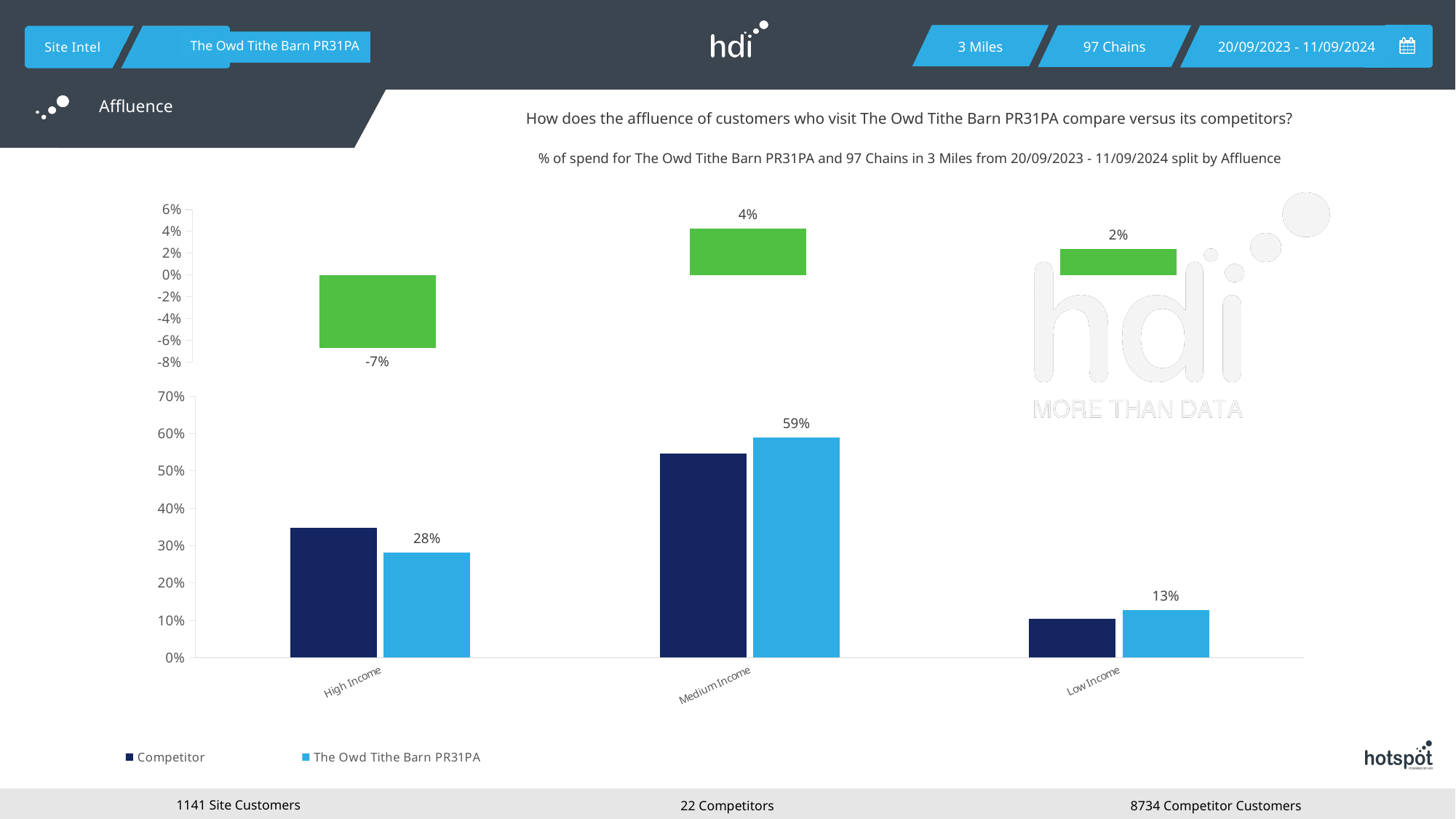
In the top chart, what is the value shown for the High Income category? -7% In the top chart, what is the value shown for the Medium Income category? 4% How many series does the legend of the bottom chart list? 2 In the bottom chart, which category has the highest value for The Owd Tithe Barn PR31PA? Medium Income In the top chart, which category has the lowest value? High Income In the bottom chart, is the Competitor value for Medium Income greater or less than 50%? greater In the bottom chart, what is the difference between The Owd Tithe Barn PR31PA values for Medium Income and High Income? 31% In the bottom chart, which is larger in the High Income category: Competitor or The Owd Tithe Barn PR31PA? Competitor What kind of chart is the bottom chart? Bar chart In the bottom chart, what is the value for The Owd Tithe Barn PR31PA in the Medium Income category? 59% In the bottom chart, what is the value for The Owd Tithe Barn PR31PA in the Low Income category? 13% In the bottom chart, what is the value for The Owd Tithe Barn PR31PA in the High Income category? 28%